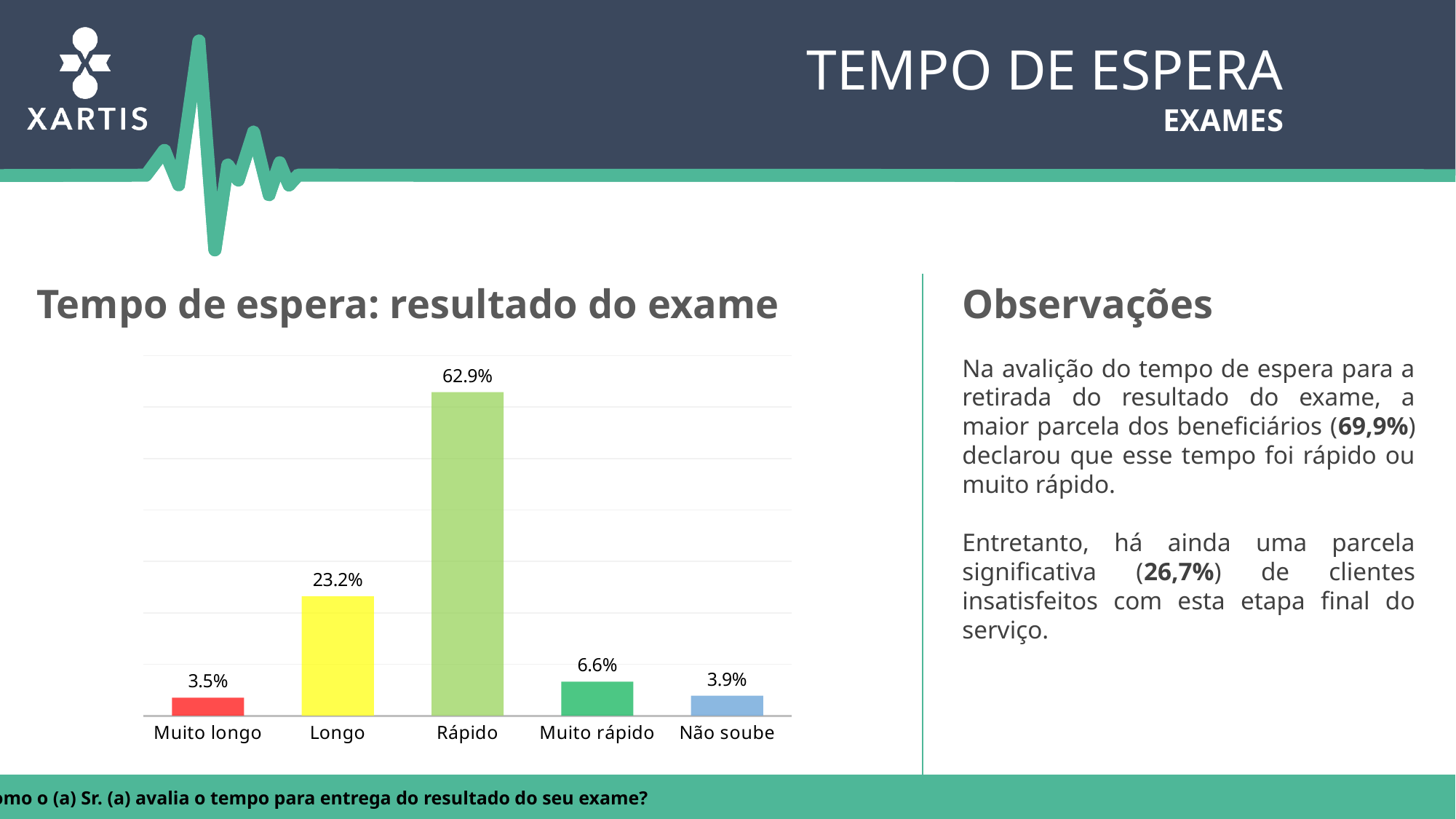
What is the value for Rápido? 62.9% How many categories are shown on the x axis? 5 What is the difference between the values for Muito rápido and Muito longo? 3.1% Which category has the lowest value? Muito longo What is the title of the chart? Tempo de espera: resultado do exame What is the value for Não soube? 3.9% What is the value for Longo? 23.2% What kind of chart is shown on the slide? Bar chart What is the difference between the values for Rápido and Longo? 39.7% Which category has the highest value? Rápido Which is larger, the value for Longo or the value for Muito rápido? Longo What is the value for Muito rápido? 6.6%